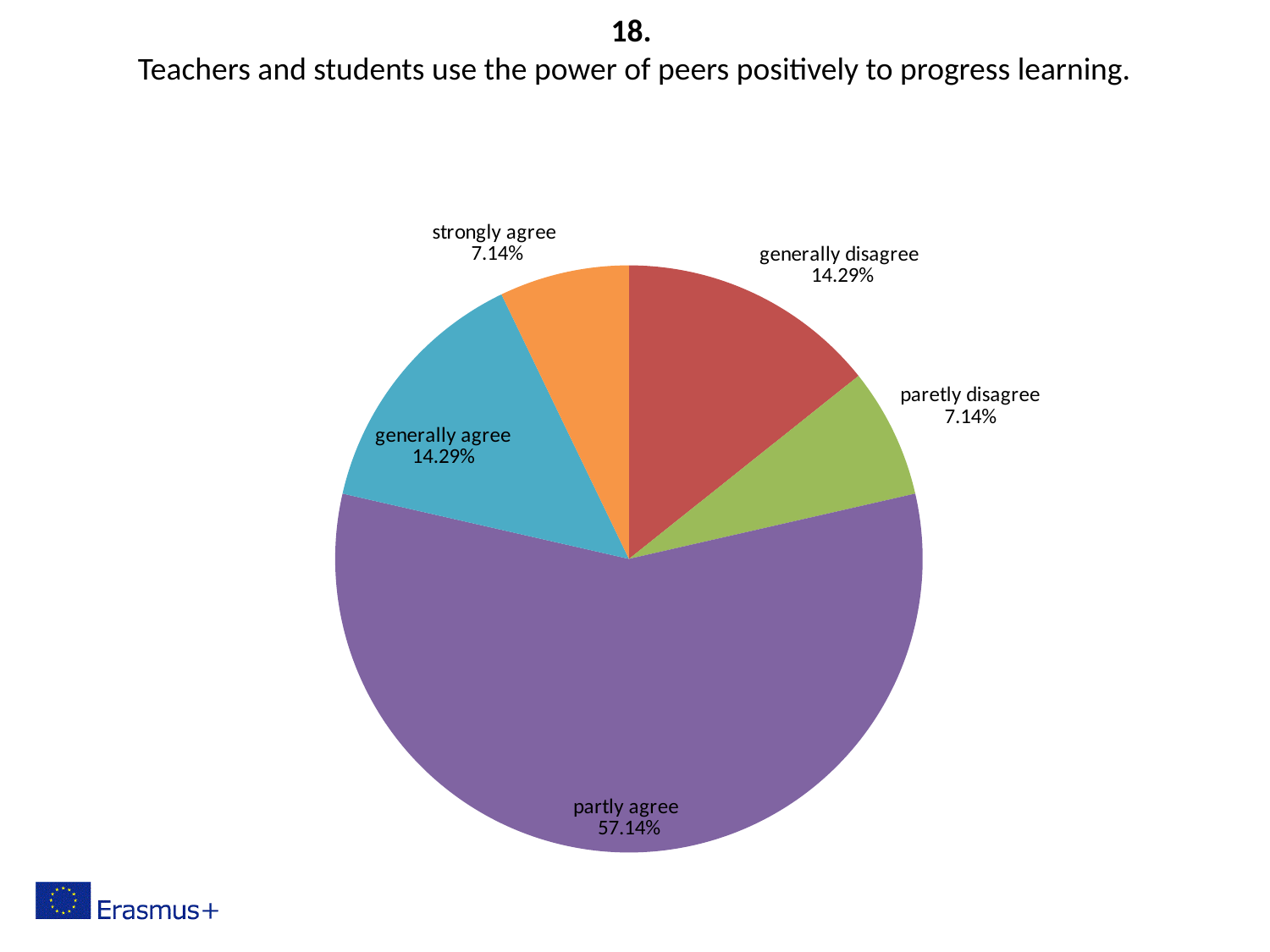
What is the value shown for 'strongly agree'? 7.14% Which is larger, the value for 'generally disagree' or the value for 'paretly disagree'? generally disagree What is the difference between the 'generally disagree' and 'strongly agree' values? 7.15% What kind of chart is shown on the slide? pie chart What is the title of the chart? Teachers and students use the power of peers positively to progress learning. What colour is the 'partly agree' slice? purple Which category has the largest slice of the pie? partly agree How many slices does the pie chart have? 5 What is the value shown for 'generally agree'? 14.29% What is the value shown for 'generally disagree'? 14.29% What is the difference between the 'partly agree' and 'generally agree' values? 42.85% What share of the pie is labelled 'partly agree'? 57.14%